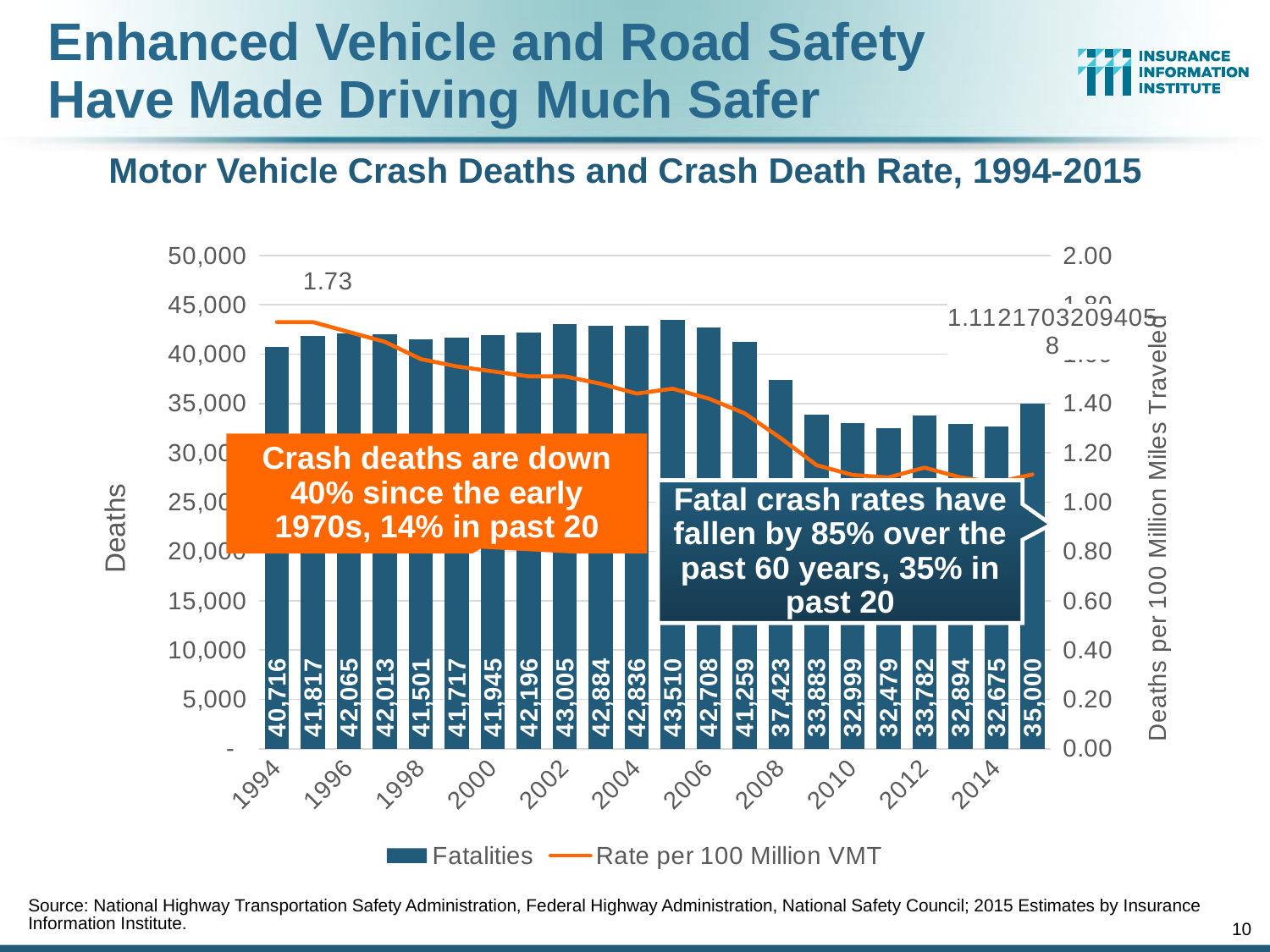
Which year had more fatalities, 2008 or 2010? 2008 Does the rate per 100 million VMT line rise or fall from 1994 to 2015? Fall Which year had the highest number of fatalities? 2005 How many fatalities were there in 2014? 32,675 How many series does the legend list? 2 How many fatalities were there in 1994? 40,716 How many fatalities were there in 2008? 37,423 What was the rate per 100 million VMT in 1994? 1.73 What is the difference in fatalities between 1994 and 2014? 8,041 Is the rate per 100 million VMT in 2010 greater or less than 1.20? less How many years (bars) are plotted in the chart? 22 What kind of chart is shown on the slide? A bar chart with a line overlay